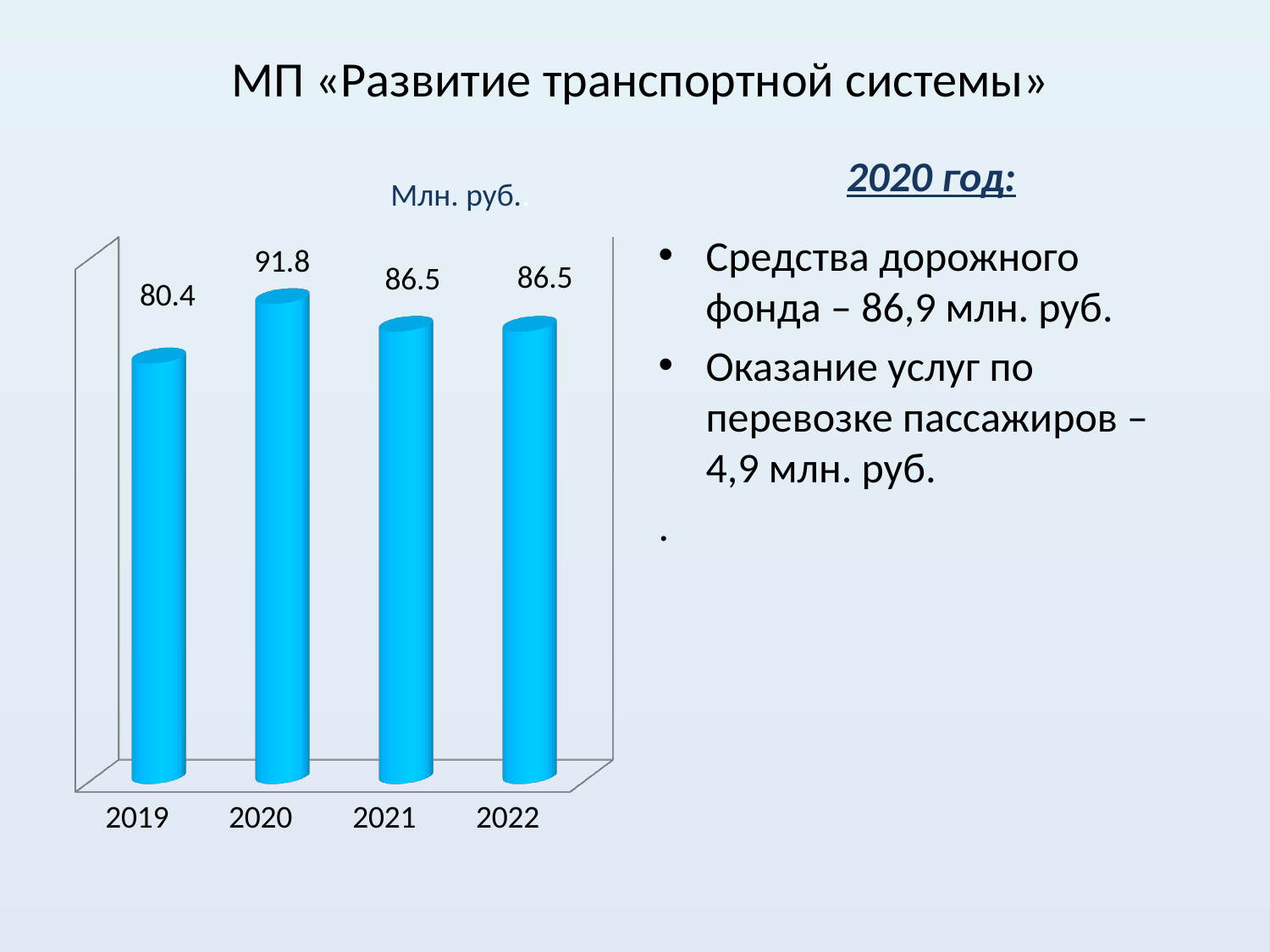
What kind of chart is shown on the slide? bar chart Does the value rise or fall from 2019 to 2020? rise What is the value for 2020? 91.8 Which year has the lowest value? 2019 What unit label is shown above the chart? Млн. руб. How many years are shown on the chart? 4 Which is larger, the value for 2019 or the value for 2022? 2022 What is the difference between the values for 2020 and 2021? 5.3 What is the value for 2019? 80.4 What is the value for 2021? 86.5 What is the difference between the values for 2020 and 2019? 11.4 Which year has the highest value? 2020